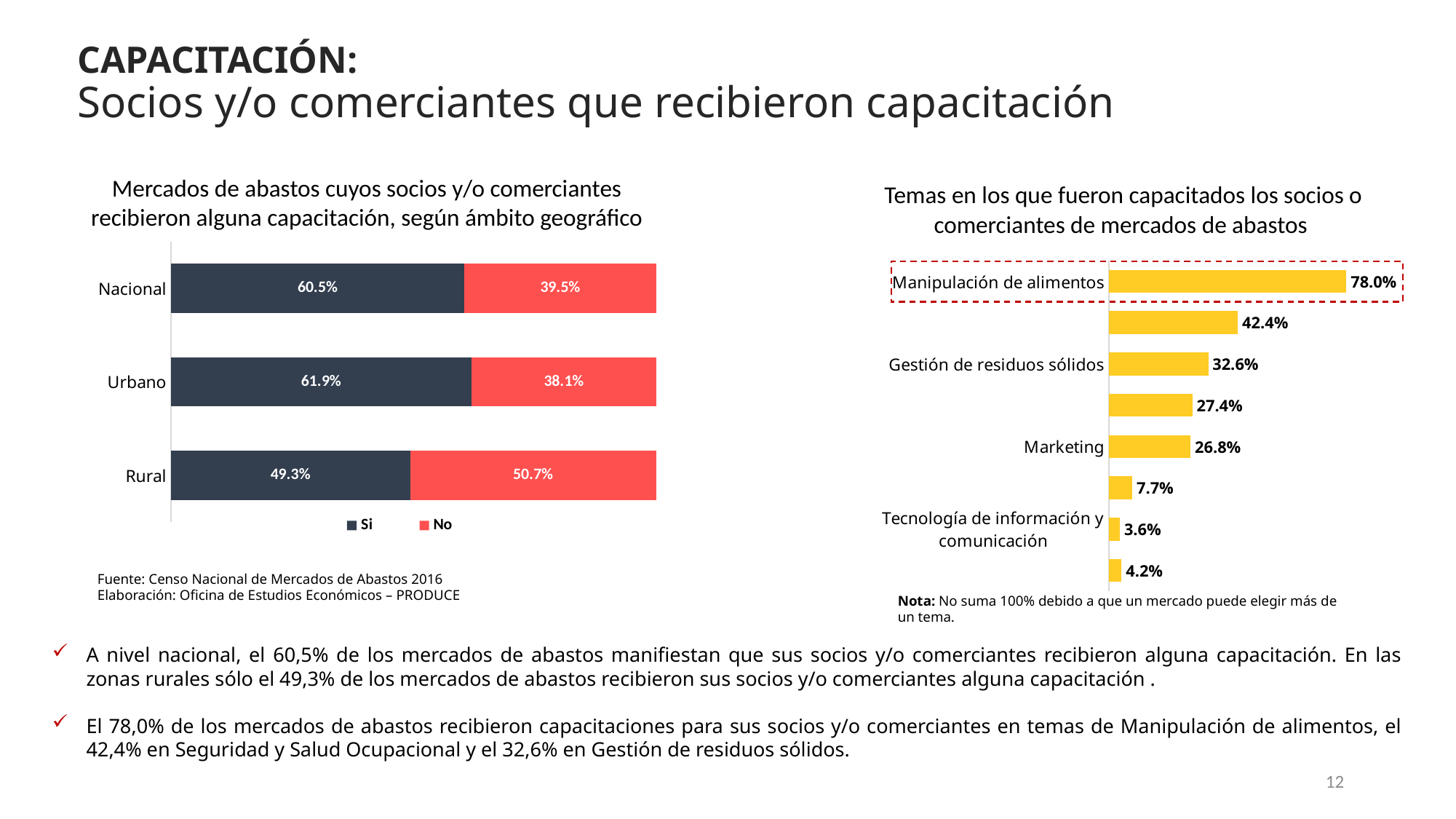
In the right chart (Temas en los que fueron capacitados), what is the value for Manipulación de alimentos? 78.0% In the right chart, what is the value for Gestión de residuos sólidos? 32.6% In the left chart, is the 'Si' value or the 'No' value larger for Rural? No In the left chart, which geographic area has the highest 'Si' value? Urbano In the left chart, what is the difference between the 'Si' values for Urbano and Rural? 12.6% In the right chart, what is the difference between Manipulación de alimentos and Marketing? 51.2% In the left chart, what is the total of the stacked bar for Urbano? 100% In the left chart, which geographic area has the lowest 'Si' value? Rural In the left chart (Mercados de abastos cuyos socios y/o comerciantes recibieron alguna capacitación), what is the 'Si' value for Nacional? 60.5% In the left chart, how many series does the legend list? 2 What kind of chart is the right chart (Temas en los que fueron capacitados)? Bar chart In the left chart, what is the 'No' value for Rural? 50.7%